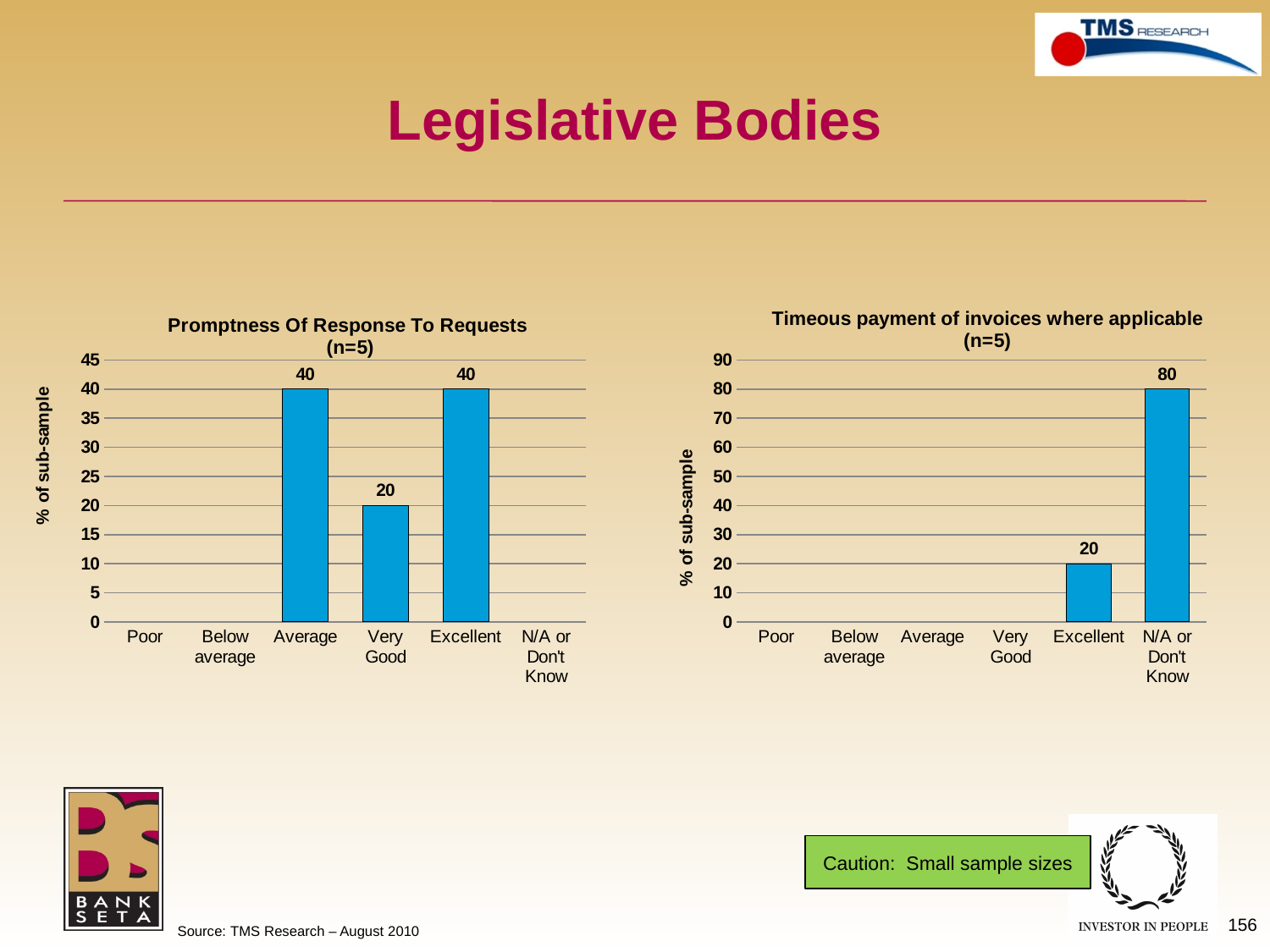
In the 'Timeous payment of invoices where applicable' chart, what is the difference between the values for N/A or Don't Know and Excellent? 60 In the 'Promptness Of Response To Requests' chart, what is the difference between the values for Average and Very Good? 20 In the 'Timeous payment of invoices where applicable' chart, what is the value for Excellent? 20 In the 'Promptness Of Response To Requests' chart, which is larger, the value for Excellent or the value for Very Good? Excellent What is the y-axis label of the 'Promptness Of Response To Requests' chart? % of sub-sample In the 'Promptness Of Response To Requests' chart, what is the value for Average? 40 In the 'Timeous payment of invoices where applicable' chart, what is the value for N/A or Don't Know? 80 What sample size (n) is stated in the title of the 'Timeous payment of invoices where applicable' chart? n=5 In the 'Promptness Of Response To Requests' chart, what is the value for Very Good? 20 How many categories are shown on the x axis of the 'Promptness Of Response To Requests' chart? 6 What kind of chart is the 'Timeous payment of invoices where applicable' chart? Bar chart In the 'Timeous payment of invoices where applicable' chart, which category has the highest value? N/A or Don't Know